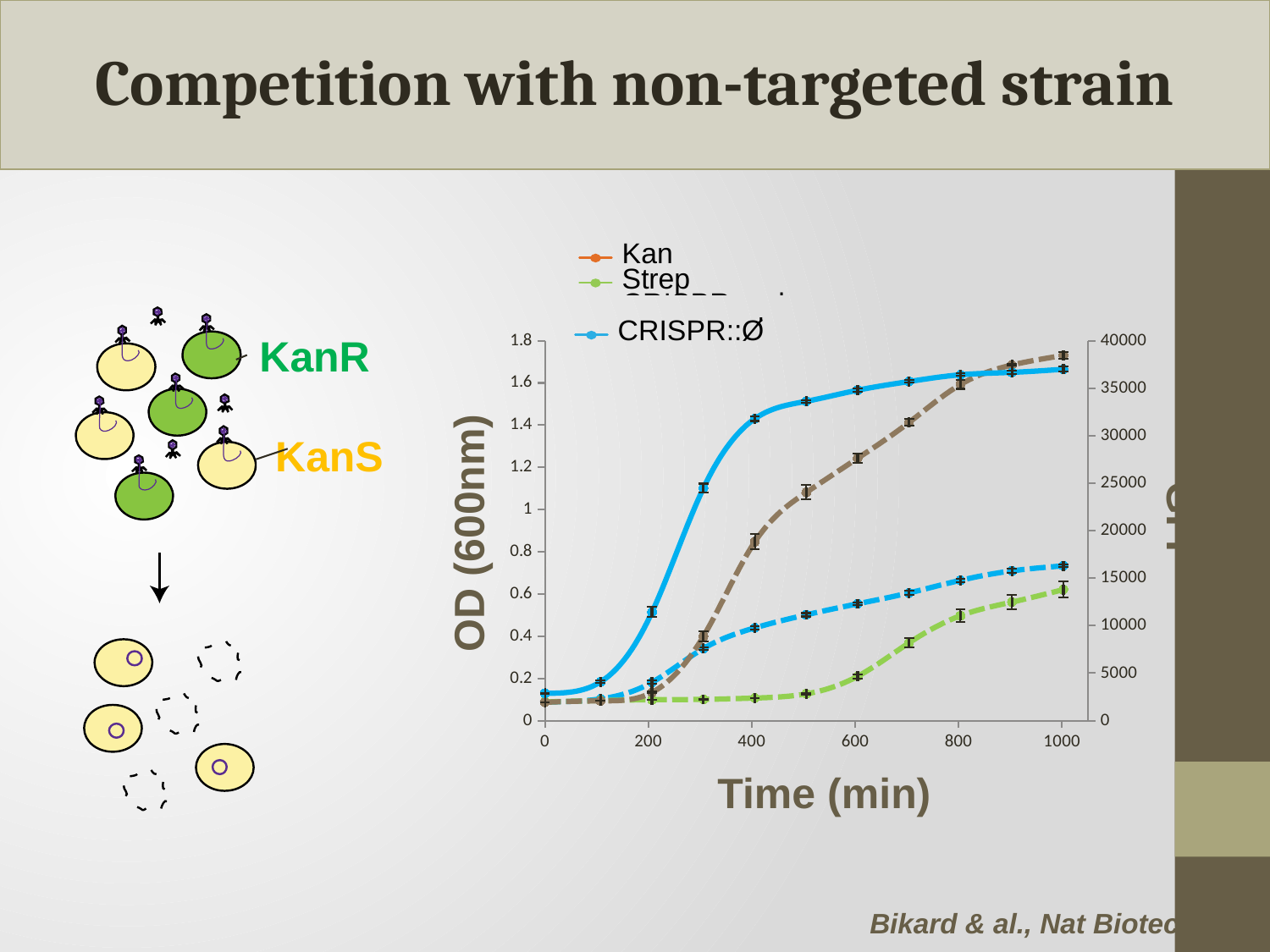
What kind of chart is shown on the slide? line chart Is the value of the dashed green line at 600 min greater or less than 0.4 on the left axis? less Is the value of the solid blue line at 1000 min greater or less than 1.4 on the left axis? greater Does the solid blue line rise or fall as time increases from 0 to 1000 min? rise Is the value of the solid blue line at 200 min greater or less than 0.8 on the left axis? less At 1000 min, which is higher on the chart: the solid blue line or the dashed green line? the solid blue line At 400 min, which is higher on the chart: the solid blue line or the dashed blue line? the solid blue line What is the title of the x axis of the chart? Time (min) What is the title of the left y axis of the chart? OD (600nm) How many tick labels are shown on the x axis of the chart? 6